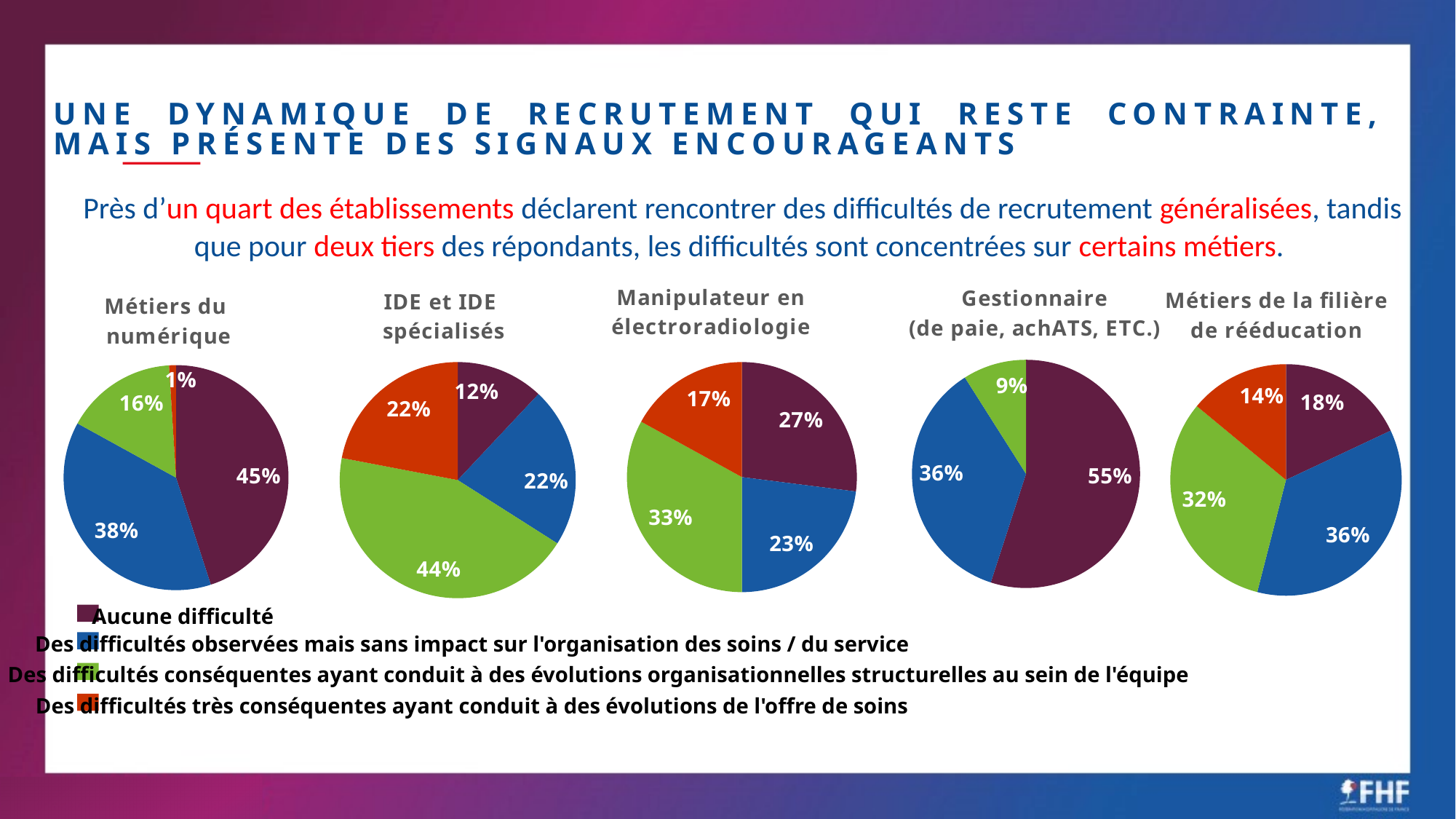
What type of chart is used for 'IDE et IDE spécialisés'? Pie chart How many slices does the 'Gestionnaire (de paie, achATS, ETC.)' pie chart have? 3 In the 'Manipulateur en électroradiologie' pie chart, which is larger: the 'Aucune difficulté' slice or the 'Des difficultés très conséquentes ayant conduit à des évolutions de l'offre de soins' slice? Aucune difficulté How many pie charts are shown on the slide? 5 In the 'Métiers de la filière de rééducation' pie chart, what is the difference between the 'Des difficultés observées mais sans impact sur l'organisation des soins / du service' slice and the 'Aucune difficulté' slice? 18% In the 'Métiers du numérique' pie chart, what share is labelled for 'Aucune difficulté'? 45% In the 'Gestionnaire (de paie, achATS, ETC.)' pie chart, what share is labelled for 'Aucune difficulté'? 55% In the 'IDE et IDE spécialisés' pie chart, what share is labelled for 'Des difficultés conséquentes ayant conduit à des évolutions organisationnelles structurelles au sein de l'équipe'? 44% In the 'Métiers de la filière de rééducation' pie chart, what share is labelled for 'Des difficultés très conséquentes ayant conduit à des évolutions de l'offre de soins'? 14% How many categories does the shared legend list? 4 In the 'Manipulateur en électroradiologie' pie chart, which category has the largest slice? Des difficultés conséquentes ayant conduit à des évolutions organisationnelles structurelles au sein de l'équipe In the 'Métiers du numérique' pie chart, which category has the smallest slice? Des difficultés très conséquentes ayant conduit à des évolutions de l'offre de soins